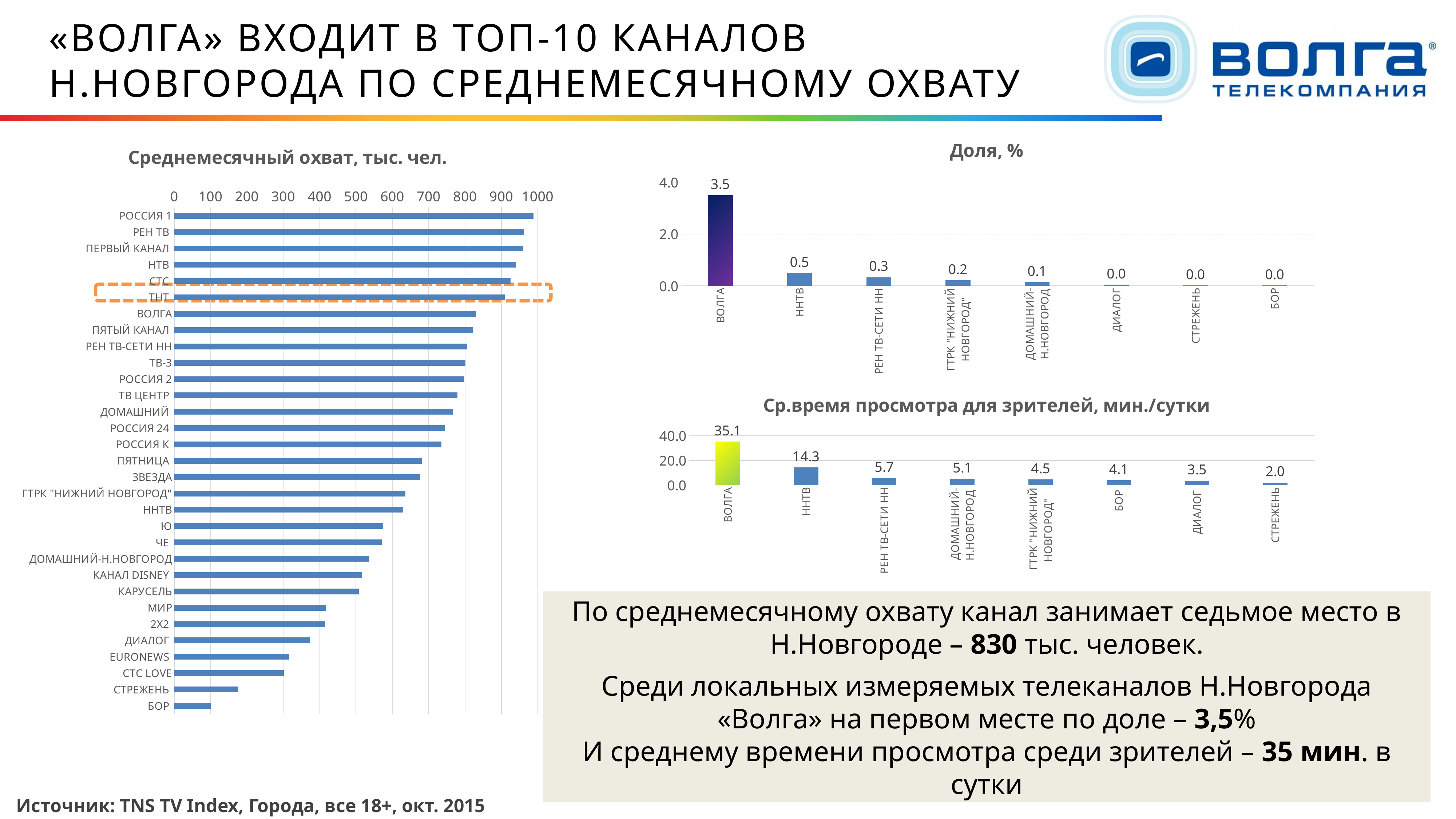
In the chart titled «Доля, %», what is the difference between ВОЛГА and ННТВ? 3.0 In the chart titled «Доля, %», how many channels are shown? 8 In the chart titled «Доля, %», what is the value for ННТВ? 0.5 In the chart titled «Доля, %», which channel has the highest share? ВОЛГА In the chart titled «Ср.время просмотра для зрителей, мин./сутки», which channel has the lowest value? СТРЕЖЕНЬ In the chart titled «Ср.время просмотра для зрителей, мин./сутки», what is the value for ВОЛГА? 35.1 In the chart titled «Ср.время просмотра для зрителей, мин./сутки», which is larger: РЕН ТВ-СЕТИ НН or БОР? РЕН ТВ-СЕТИ НН In the chart titled «Среднемесячный охват, тыс. чел.», which channel has the highest value? РОССИЯ 1 In the chart titled «Доля, %», what is the value for ВОЛГА? 3.5 In the chart titled «Среднемесячный охват, тыс. чел.», is the value for СТРЕЖЕНЬ greater or less than 200? less In the chart titled «Ср.время просмотра для зрителей, мин./сутки», what is the value for СТРЕЖЕНЬ? 2.0 What kind of chart is the chart titled «Среднемесячный охват, тыс. чел.»? bar chart